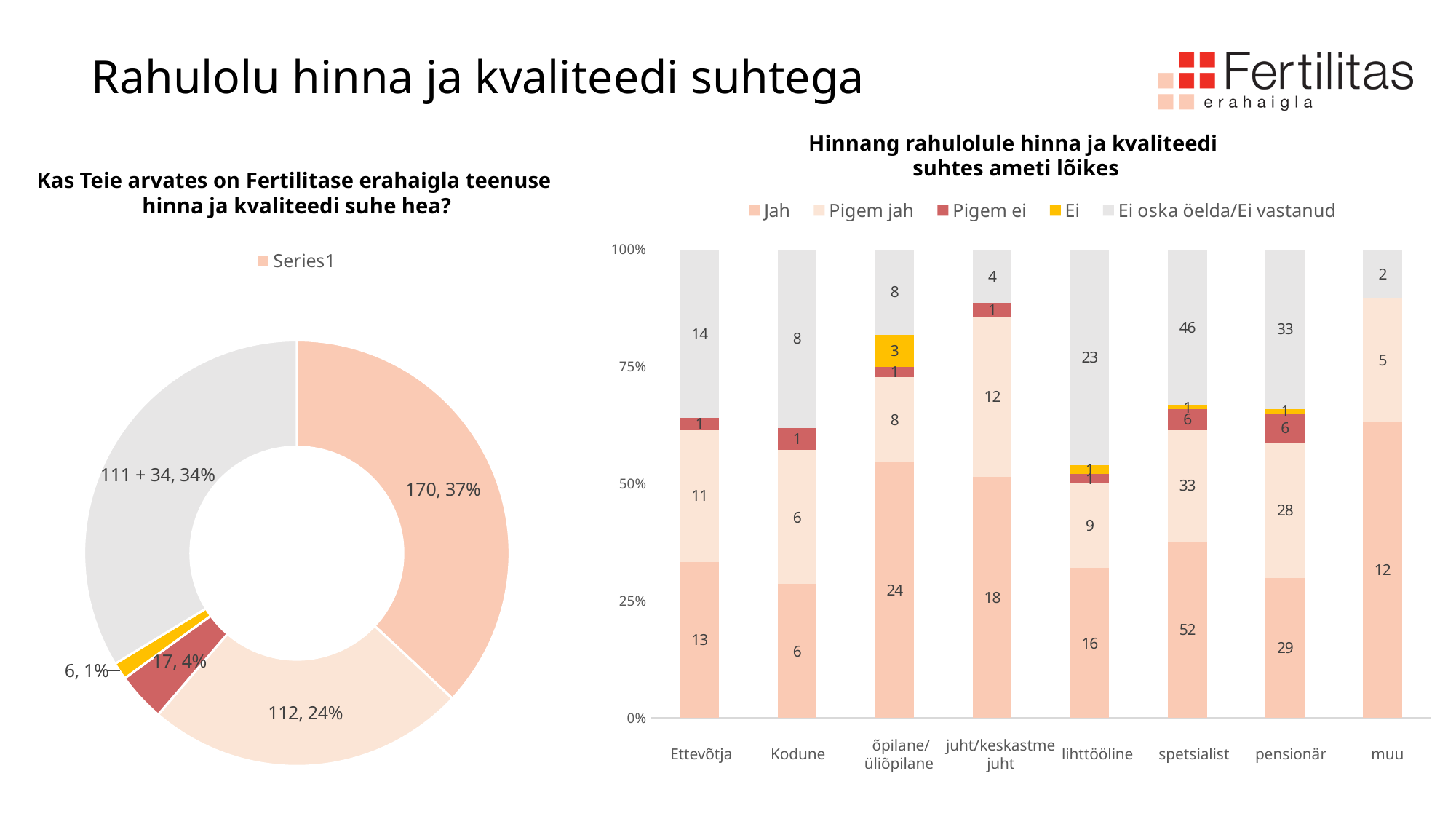
In the left-hand donut chart 'Kas Teie arvates on Fertilitase erahaigla teenuse hinna ja kvaliteedi suhe hea?', what share does the largest slice have? 37% In the right-hand chart 'Hinnang rahulolule hinna ja kvaliteedi suhtes ameti lõikes', what is the total of all labelled segments in the Ettevõtja bar? 39 In the right-hand chart 'Hinnang rahulolule hinna ja kvaliteedi suhtes ameti lõikes', what is the 'Ei' value for õpilane/üliõpilane? 3 In the right-hand chart 'Hinnang rahulolule hinna ja kvaliteedi suhtes ameti lõikes', what is the 'Jah' value for spetsialist? 52 In the right-hand chart 'Hinnang rahulolule hinna ja kvaliteedi suhtes ameti lõikes', which has the larger 'Pigem jah' value, spetsialist or pensionär? spetsialist In the right-hand chart 'Hinnang rahulolule hinna ja kvaliteedi suhtes ameti lõikes', which occupation has the highest 'Jah' value? spetsialist How many series does the legend of the right-hand chart 'Hinnang rahulolule hinna ja kvaliteedi suhtes ameti lõikes' list? 5 In the right-hand chart 'Hinnang rahulolule hinna ja kvaliteedi suhtes ameti lõikes', what is the 'Ei oska öelda/Ei vastanud' value for lihttööline? 23 What kind of chart is the right-hand chart titled 'Hinnang rahulolule hinna ja kvaliteedi suhtes ameti lõikes'? Stacked bar chart In the left-hand donut chart 'Kas Teie arvates on Fertilitase erahaigla teenuse hinna ja kvaliteedi suhe hea?', what is the count value of the slice labelled 24%? 112 How many occupation categories are shown on the x axis of the right-hand chart 'Hinnang rahulolule hinna ja kvaliteedi suhtes ameti lõikes'? 8 In the right-hand chart 'Hinnang rahulolule hinna ja kvaliteedi suhtes ameti lõikes', how much larger is the 'Jah' value for spetsialist than for pensionär? 23